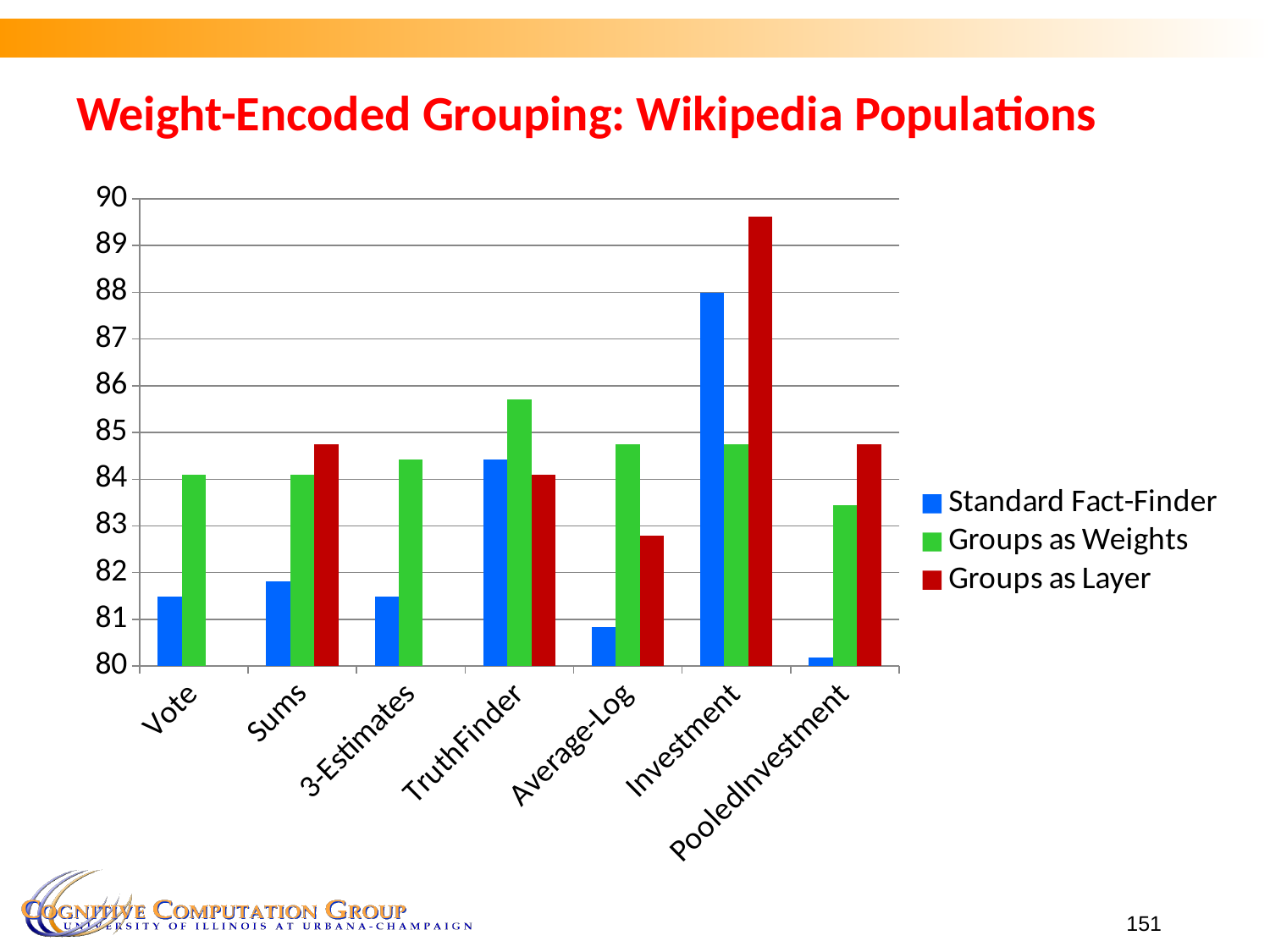
Which category has the highest value for the Standard Fact-Finder series? Investment Is the Groups as Layer value for Investment greater or less than 89? greater What kind of chart is shown on the slide? bar chart Which category has the lowest value for the Standard Fact-Finder series? PooledInvestment Which category has the highest value for the Groups as Layer series? Investment Which category has the highest value for the Groups as Weights series? TruthFinder For Investment, which is larger: Standard Fact-Finder or Groups as Weights? Standard Fact-Finder How many categories are shown along the x axis? 7 Is the Standard Fact-Finder value for Vote greater or less than 82? less Which category has the lowest value for the Groups as Layer series? Average-Log How many series does the legend list? 3 What is the title of the chart? Weight-Encoded Grouping: Wikipedia Populations